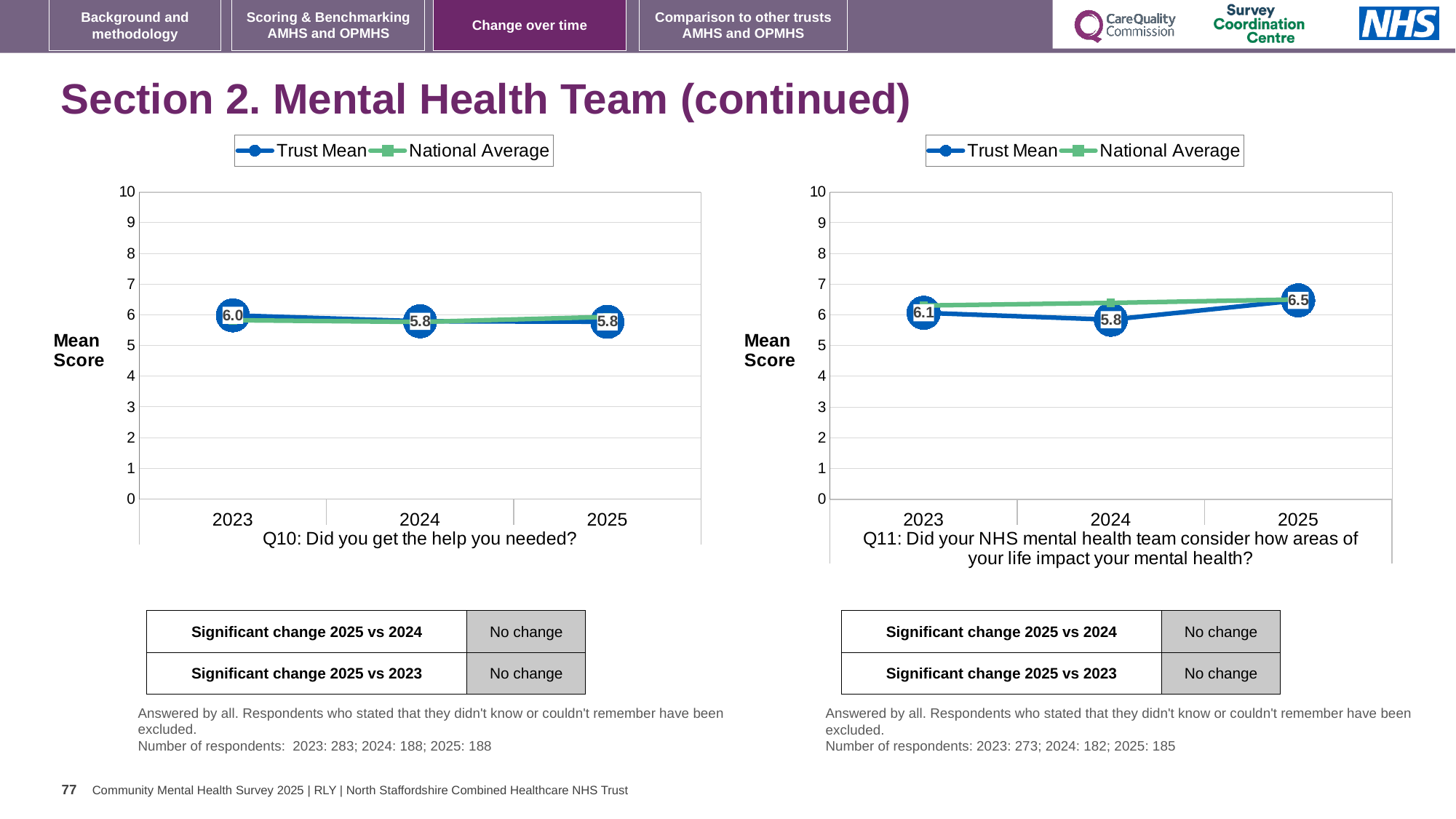
In the Q10 chart (left), what is the Trust Mean for 2025? 5.8 In the Q11 chart (right), which year has the lowest Trust Mean? 2024 In the Q11 chart (right), what is the Trust Mean for 2025? 6.5 In the Q11 chart (right), what is the Trust Mean for 2024? 5.8 In the Q11 chart (right), what is the difference between the Trust Mean for 2025 and 2024? 0.7 In the Q11 chart (right), which year has the highest Trust Mean? 2025 How many years are shown on the x axis of the Q10 chart (left)? 3 In the Q11 chart (right), is the National Average for 2025 greater or less than 5? greater What type of chart is the Q10 chart (left)? Line chart In the Q10 chart (left), what is the Trust Mean for 2023? 6.0 In the Q10 chart (left), is the Trust Mean for 2023 larger or smaller than the Trust Mean for 2024? larger How many series does the legend of the Q11 chart (right) list? 2